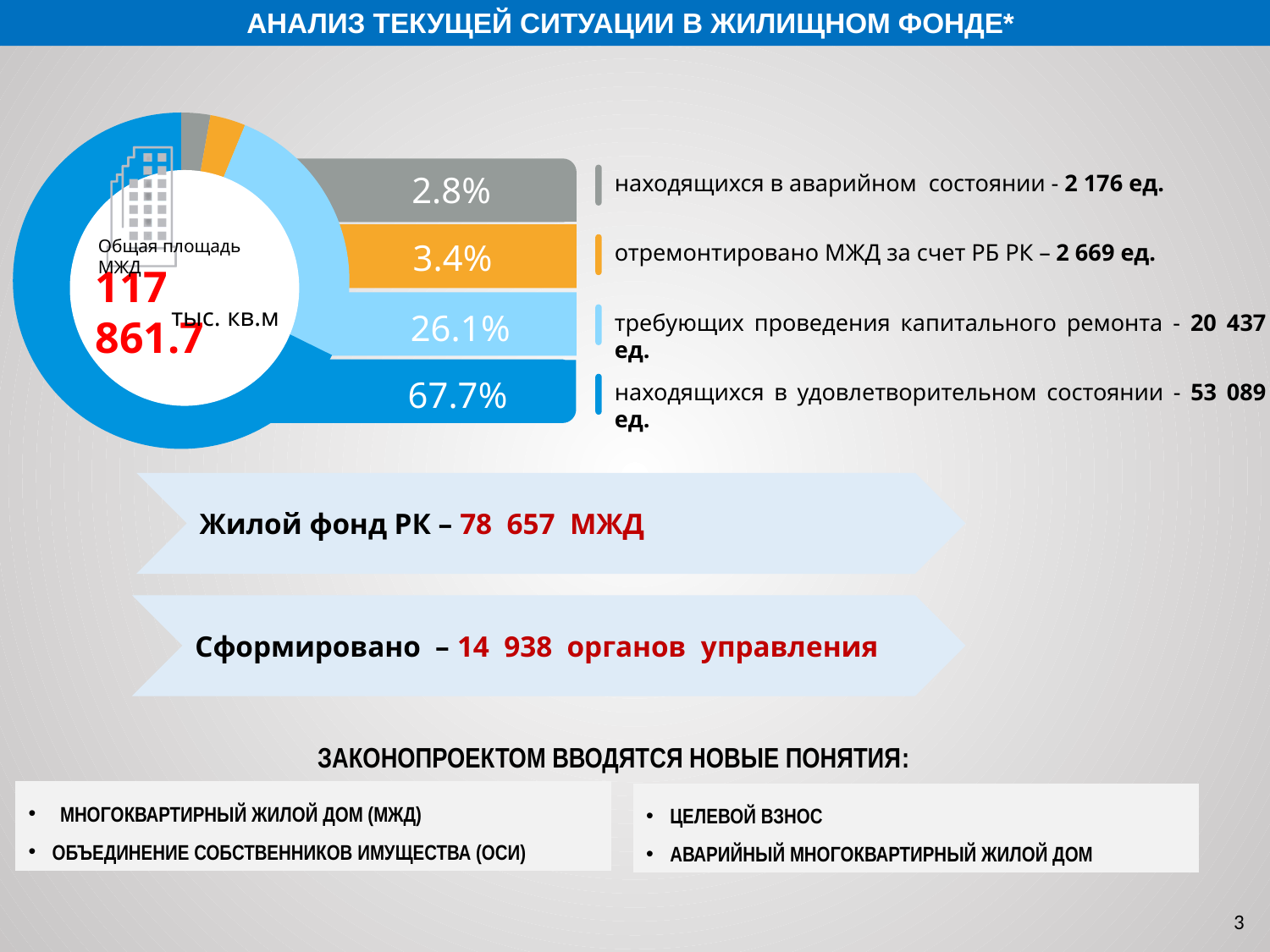
What kind of chart is shown on the slide? Donut (pie) chart How many units (ед.) of housing require capital repair? 20 437 ед. Which category has the smallest share in the donut chart? находящихся в аварийном состоянии (2.8%) What is the difference in percentage points between the share in satisfactory condition and the share requiring capital repair? 41.6 percentage points What share of the housing stock is in emergency condition (в аварийном состоянии)? 2.8% How many units (ед.) of housing are in satisfactory condition? 53 089 ед. How many slices does the donut chart have? 4 What share of the housing stock is in satisfactory condition (в удовлетворительном состоянии)? 67.7% What share of the housing stock requires capital repair (требующих проведения капитального ремонта)? 26.1% Which category has the largest share in the donut chart? находящихся в удовлетворительном состоянии (67.7%) What total area of MЖД is shown in the centre of the donut chart? 117 861.7 тыс. кв.м What share of the housing stock was repaired at the expense of the RB RK (отремонтировано МЖД за счет РБ РК)? 3.4%